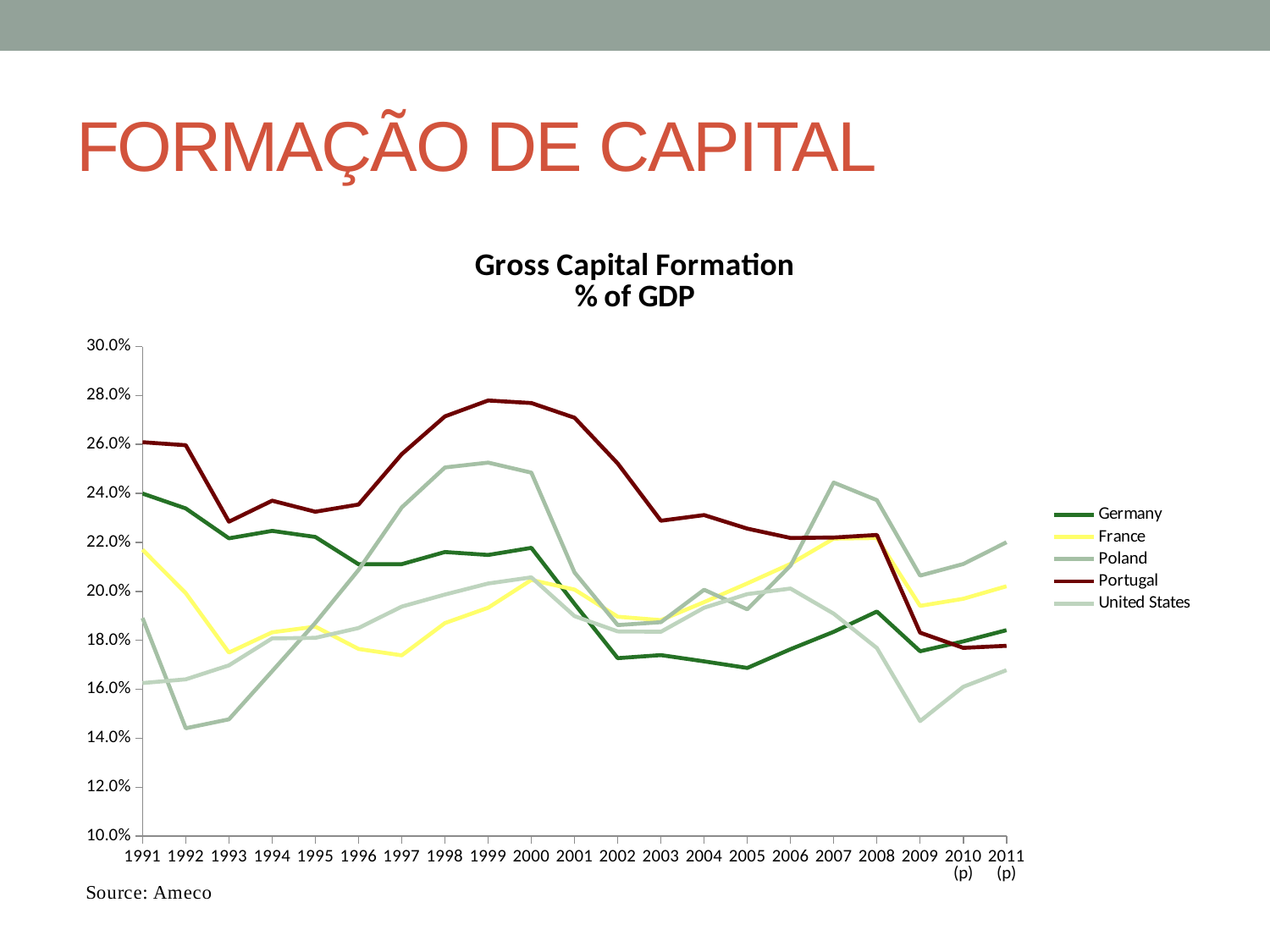
Is the value for Germany in 2005 greater or less than 18.0%? less Is the value for Portugal in 1999 greater or less than 26.0%? greater Which country has the lowest value in 1991? United States In 2002, which is larger, the value for France or the value for Germany? France Is the value for Poland in 1992 greater or less than 16.0%? less How many series does the legend list? 5 Does the value for Portugal rise or fall from 2000 to 2003? fall How many years are shown along the x axis? 21 Which country has the highest value in 1991? Portugal What kind of chart is shown on the slide? line chart What is the title of the chart? Gross Capital Formation % of GDP Which country has the highest value in 2011 (p)? Poland